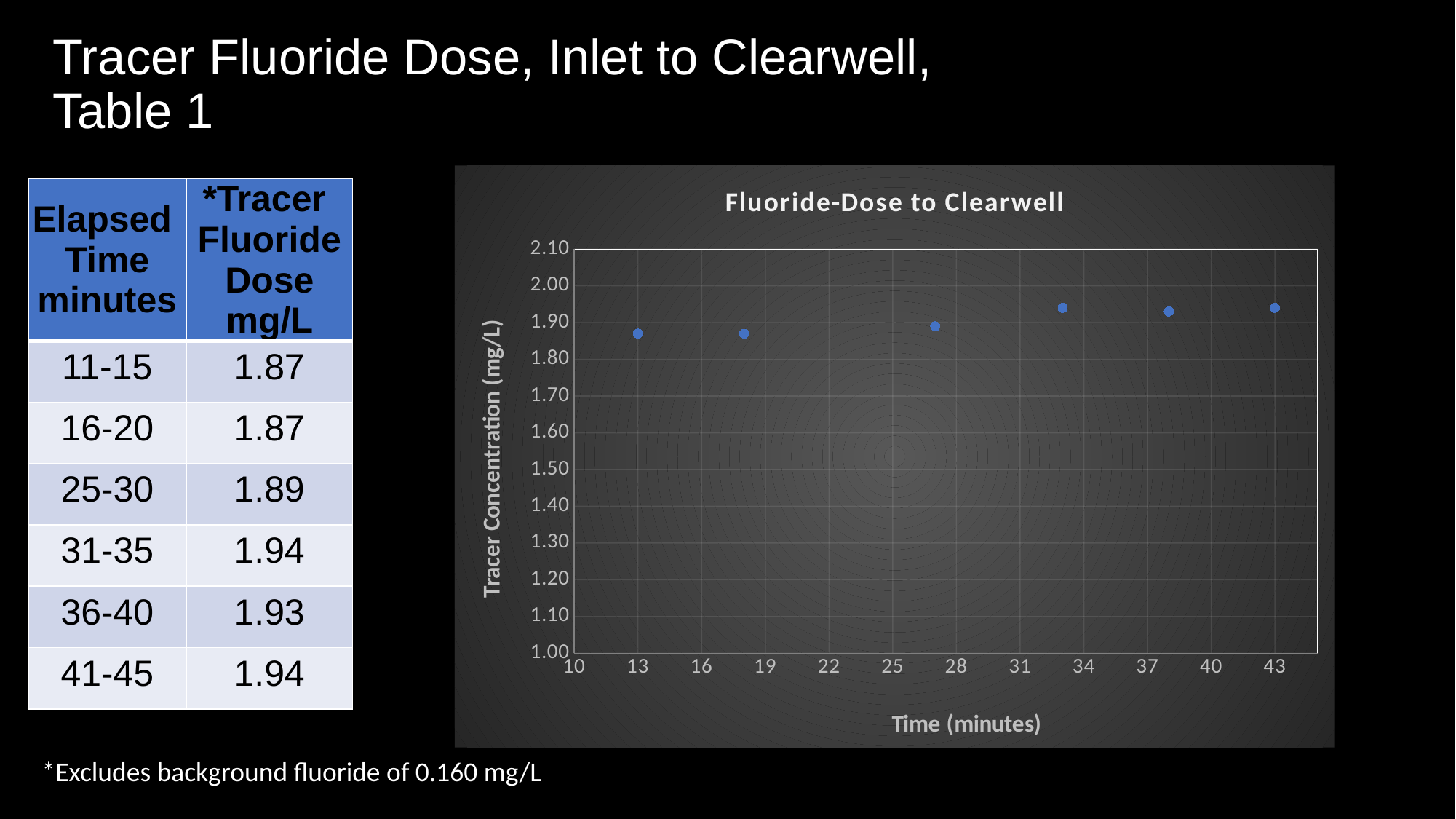
Using the table values, which interval has the larger tracer fluoride dose, 25-30 minutes or 31-35 minutes? 31-35 According to the table on the slide, what is the tracer fluoride dose for the 25-30 minute interval? 1.89 Using the table values, what is the difference between the tracer fluoride dose at 41-45 minutes and at 11-15 minutes? 0.07 What is the label of the vertical axis of the chart? Tracer Concentration (mg/L) Do the plotted tracer concentration values generally rise or fall as time increases along the x axis? rise According to the table on the slide, what is the tracer fluoride dose for the 36-40 minute interval? 1.93 In the chart, is the value of the point plotted near 27 minutes greater or less than 1.80? greater What is the title of the chart? Fluoride-Dose to Clearwell How many data points are plotted in the Fluoride-Dose to Clearwell chart? 6 What kind of chart is shown on the slide? scatter chart In the chart, is the value of the point plotted near 13 minutes greater or less than 1.90? less In the chart, is the value of the point plotted near 43 minutes greater or less than 1.90? greater